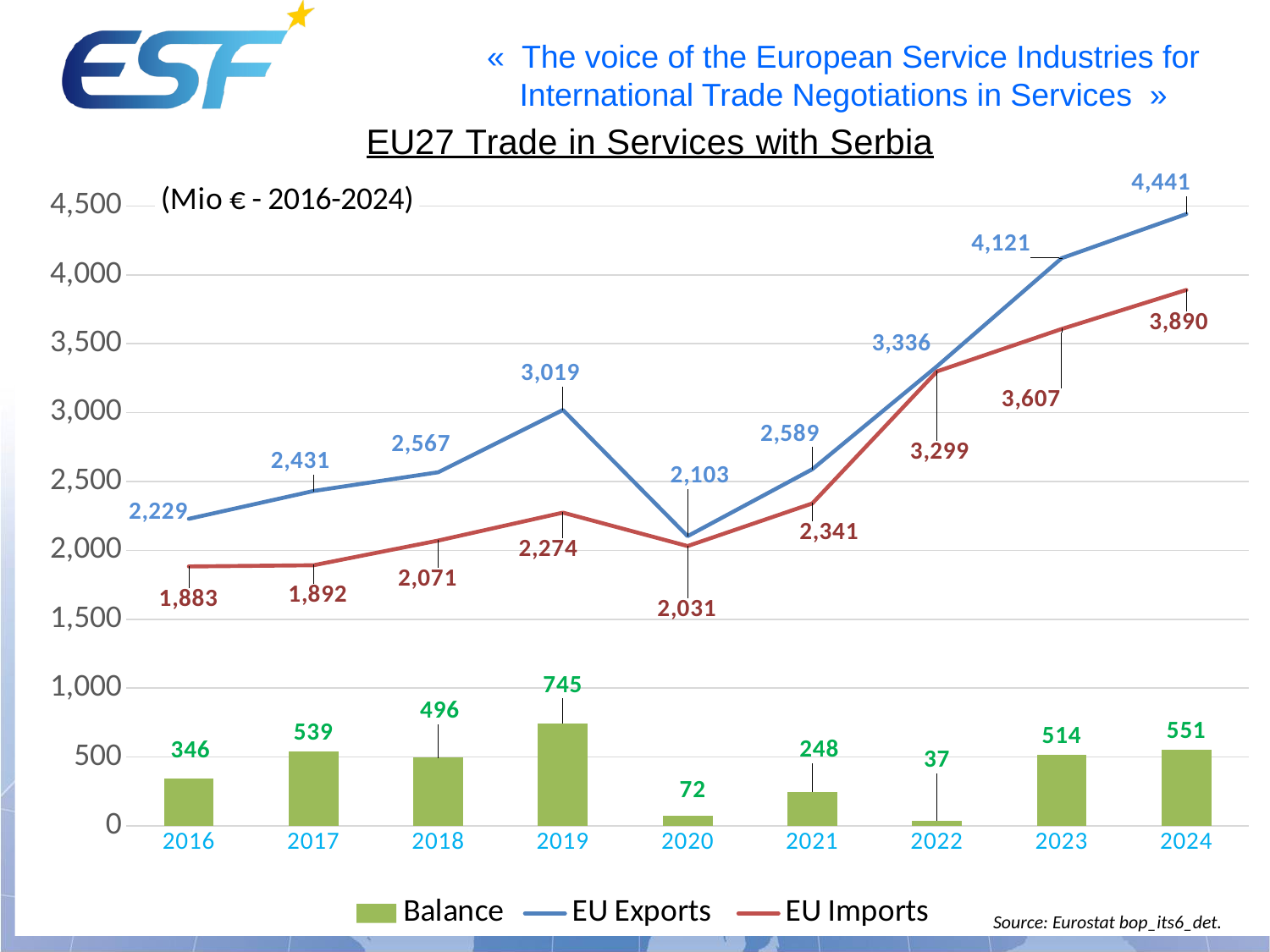
In which year was the Balance lowest? 2022 What is the difference between EU Exports and EU Imports in 2024? 551 In which year was the Balance highest? 2019 How many series does the legend list? 3 Which was larger in 2021, EU Exports or EU Imports? EU Exports How many years are shown on the x axis? 9 What was the value of EU Exports in 2019? 3,019 Did EU Imports rise or fall from 2019 to 2020? fall What was the value of EU Imports in 2022? 3,299 What was the Balance in 2020? 72 What is the title of the chart? EU27 Trade in Services with Serbia In which year were EU Exports highest? 2024